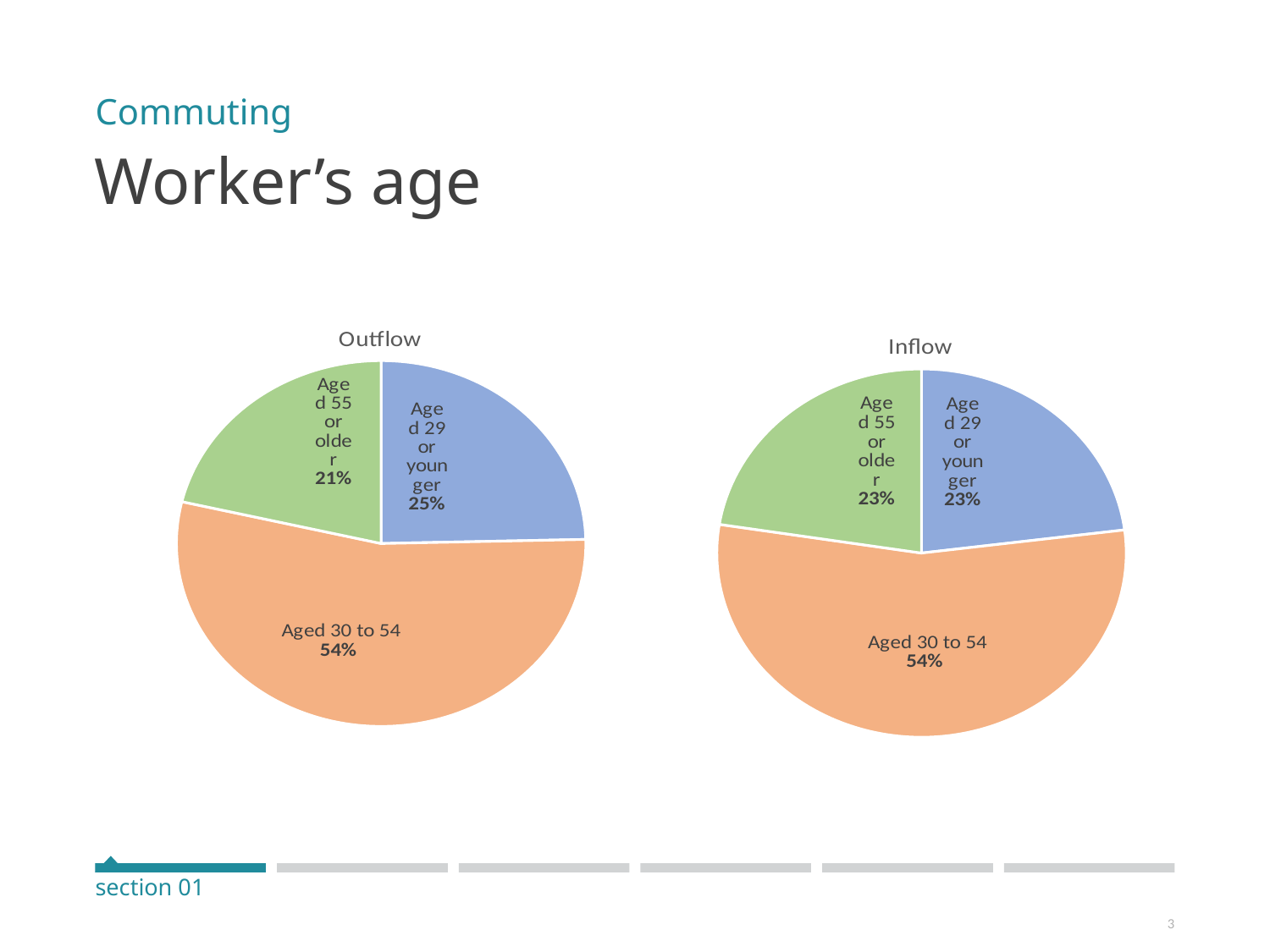
In the Outflow chart, which is larger: the share aged 29 or younger or the share aged 55 or older? Aged 29 or younger In the Inflow chart, what share of workers are aged 55 or older? 23% What colour is the Aged 30 to 54 slice in the Inflow chart? Orange In the Outflow chart, what share of workers are aged 55 or older? 21% In the Inflow chart, which age group has the largest share? Aged 30 to 54 In the Outflow chart, which age group has the smallest share? Aged 55 or older What type of chart is used for the Outflow data? Pie chart How many slices does the Inflow chart have? 3 In the Outflow chart, what share of workers are aged 30 to 54? 54% In the Outflow chart, what is the difference in percentage points between the Aged 30 to 54 share and the Aged 29 or younger share? 29 percentage points In the Outflow chart, what share of workers are aged 29 or younger? 25% In the Inflow chart, what share of workers are aged 29 or younger? 23%